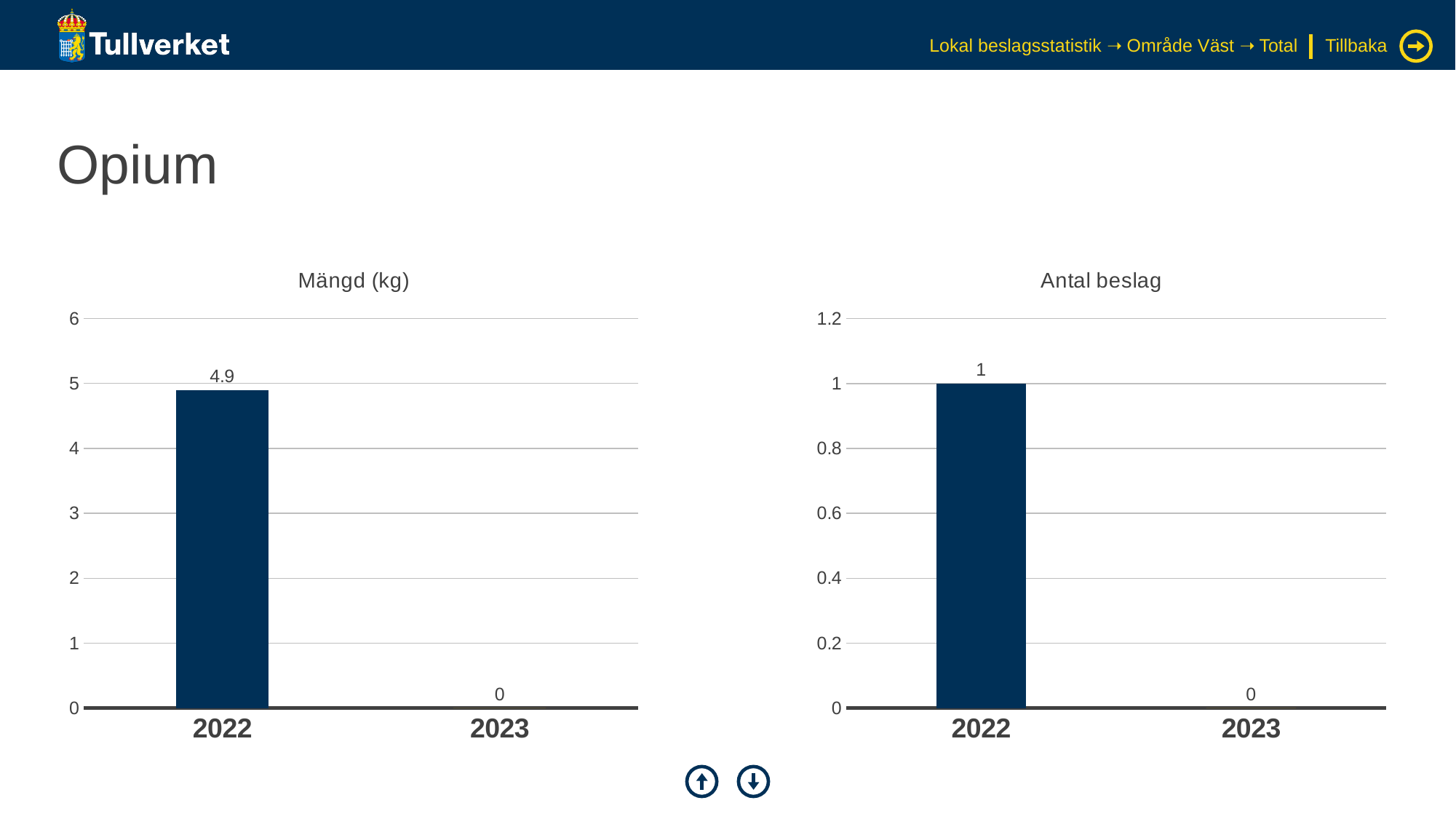
In the 'Mängd (kg)' chart, what is the value for 2023? 0 In the 'Antal beslag' chart, what is the value for 2023? 0 What kind of chart is the 'Mängd (kg)' chart? bar chart In the 'Mängd (kg)' chart, what is the difference between the values for 2022 and 2023? 4.9 In the 'Antal beslag' chart, which is larger, the value for 2022 or the value for 2023? 2022 In the 'Mängd (kg)' chart, what is the value for 2022? 4.9 How many categories are shown on the x axis of the 'Antal beslag' chart? 2 In the 'Mängd (kg)' chart, do the values rise or fall from 2022 to 2023? fall In the 'Antal beslag' chart, what is the value for 2022? 1 In the 'Mängd (kg)' chart, is the value for 2022 greater or less than 4? greater In the 'Antal beslag' chart, which year has the lowest value? 2023 In the 'Mängd (kg)' chart, which year has the highest value? 2022